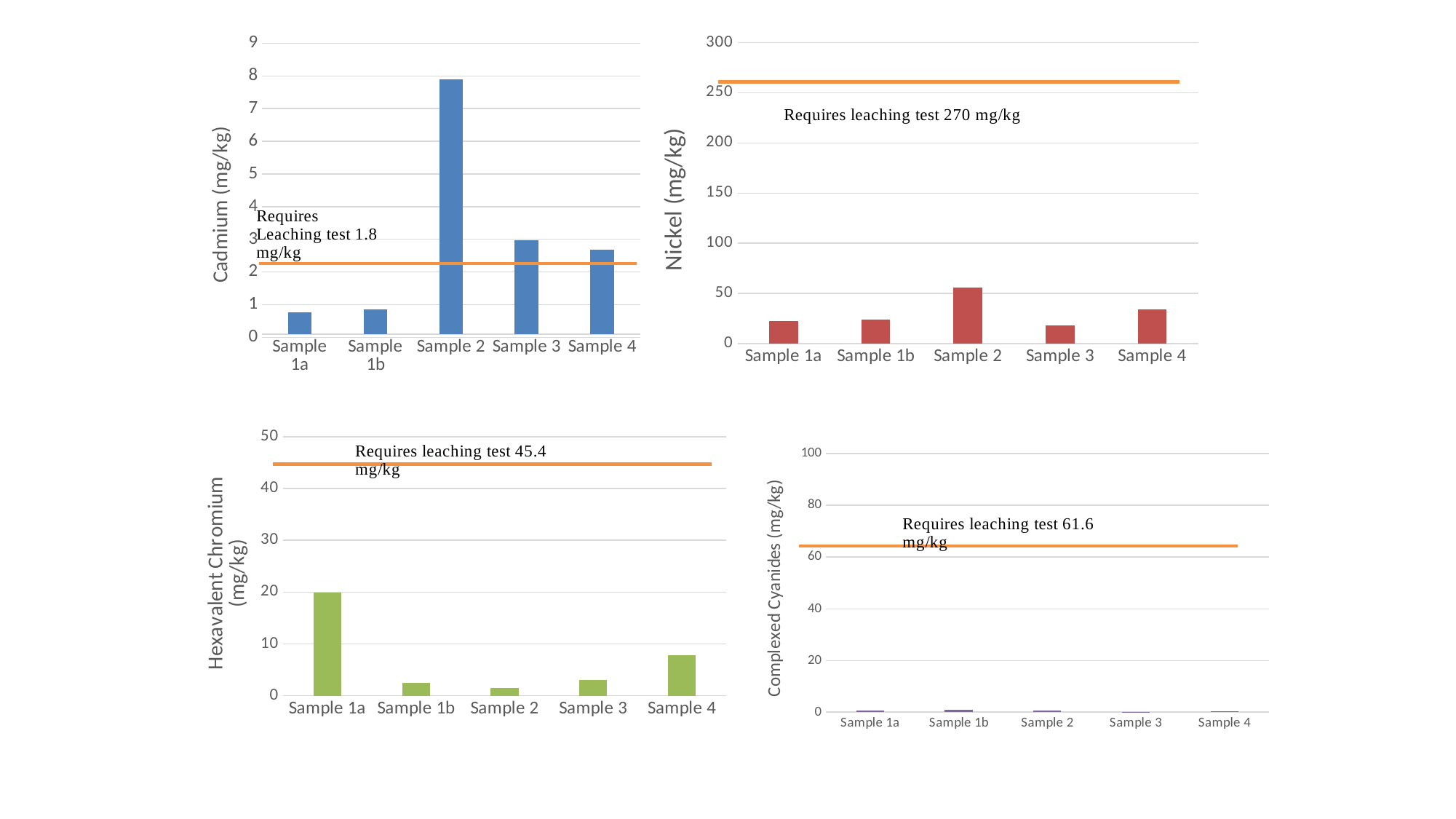
In the Cadmium chart (top left), which sample has the highest value? Sample 2 In the Hexavalent Chromium chart (bottom left), which is larger, the value for Sample 4 or the value for Sample 3? Sample 4 In the Nickel chart (top right), which sample has the lowest value? Sample 3 In the Hexavalent Chromium chart (bottom left), is the value for Sample 1a greater or less than 10? greater What kind of chart is the Hexavalent Chromium chart (bottom left)? bar chart In the Complexed Cyanides chart (bottom right), is the value for Sample 1b greater or less than 20? less In the Nickel chart (top right), is the value for Sample 4 greater or less than 50? less In the Nickel chart (top right), which sample has the highest value? Sample 2 In the Hexavalent Chromium chart (bottom left), which sample has the highest value? Sample 1a How many samples are shown on the x axis of the Nickel chart (top right)? 5